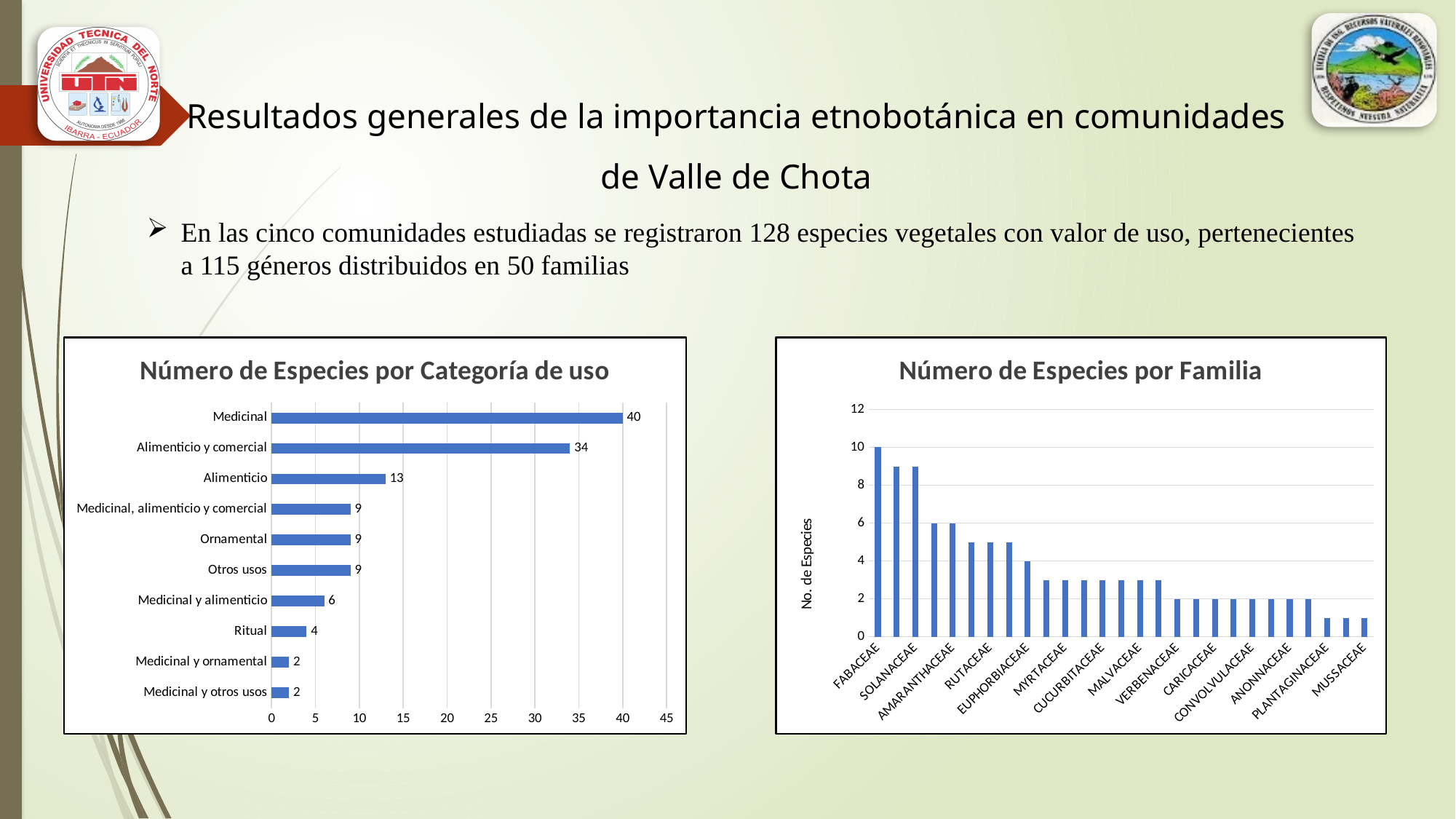
In the chart 'Número de Especies por Categoría de uso', what is the value for Alimenticio y comercial? 34 In the chart 'Número de Especies por Categoría de uso', what is the difference between Medicinal and Alimenticio y comercial? 6 In the chart 'Número de Especies por Categoría de uso', which is larger, Alimenticio or Medicinal y alimenticio? Alimenticio In the chart 'Número de Especies por Categoría de uso', how many categories are shown? 10 In the chart 'Número de Especies por Categoría de uso', which category has the highest number of species? Medicinal What kind of chart is 'Número de Especies por Categoría de uso'? Bar chart In the chart 'Número de Especies por Categoría de uso', what is the value for Ritual? 4 In the chart 'Número de Especies por Familia', do the values rise or fall from left to right along the x axis? Fall In the chart 'Número de Especies por Familia', is the value for FABACEAE greater or less than 8? greater What is the y-axis label of the chart 'Número de Especies por Familia'? No. de Especies In the chart 'Número de Especies por Familia', which family has the highest number of species? FABACEAE In the chart 'Número de Especies por Categoría de uso', how many species are in the Medicinal category? 40